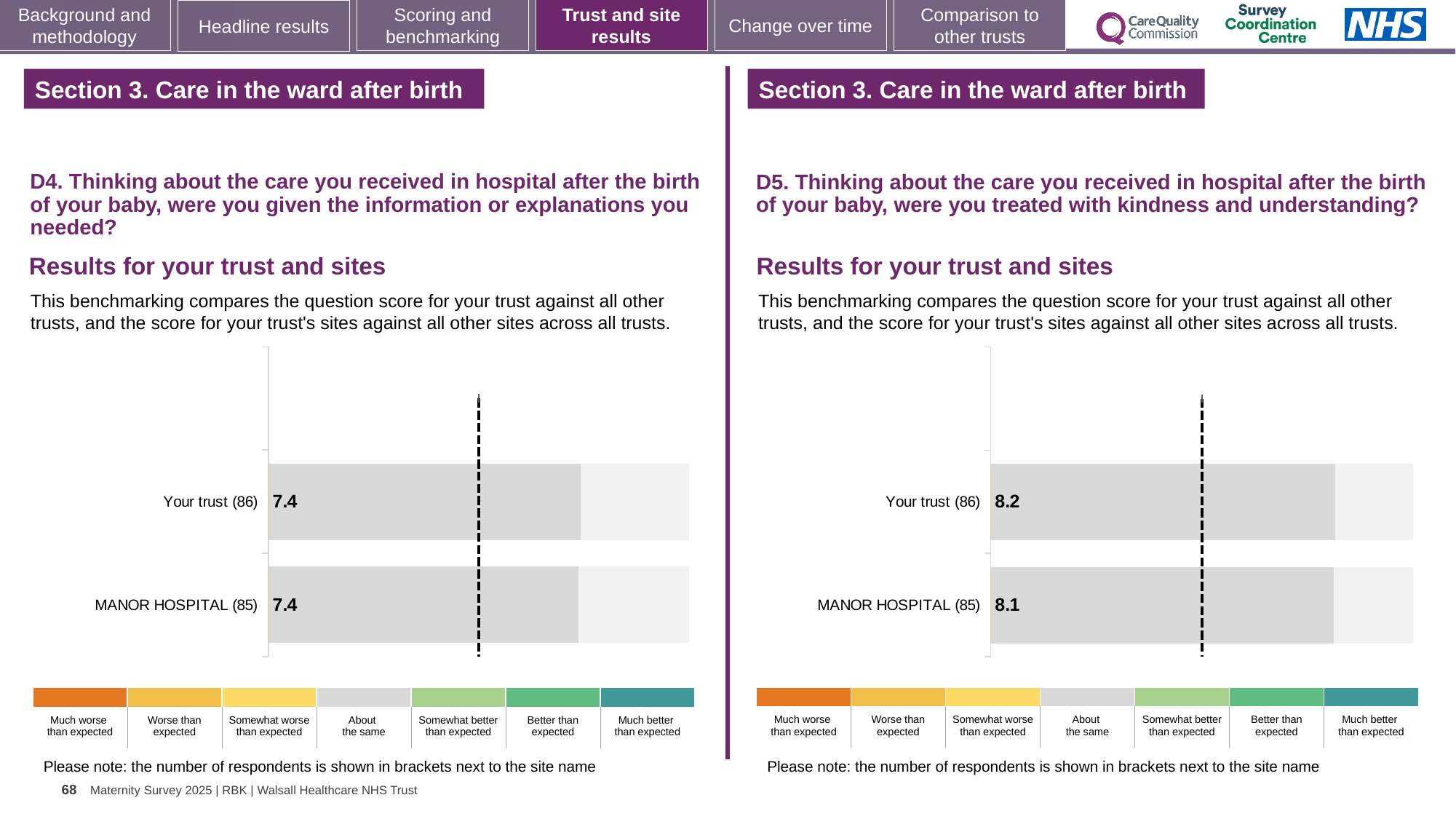
In the right chart (D5), what is the score for Your trust? 8.2 In the right chart (D5), which has the higher score, Your trust or MANOR HOSPITAL? Your trust In the right chart (D5), what is the difference between the Your trust score and the MANOR HOSPITAL score? 0.1 In the left chart (D4), what is the score for Your trust? 7.4 How many bars are plotted in the left chart (D4)? 2 In the right chart (D5), what is the score for MANOR HOSPITAL? 8.1 In the right chart (D5), how many respondents are shown in brackets for Your trust? 86 What type of chart is used in the left chart (D4)? Bar chart In the left chart (D4), how many respondents are shown in brackets for MANOR HOSPITAL? 85 In the left chart (D4), what is the difference between the Your trust score and the MANOR HOSPITAL score? 0 In the left chart (D4), what is the score for MANOR HOSPITAL? 7.4 How many bars are plotted in the right chart (D5)? 2